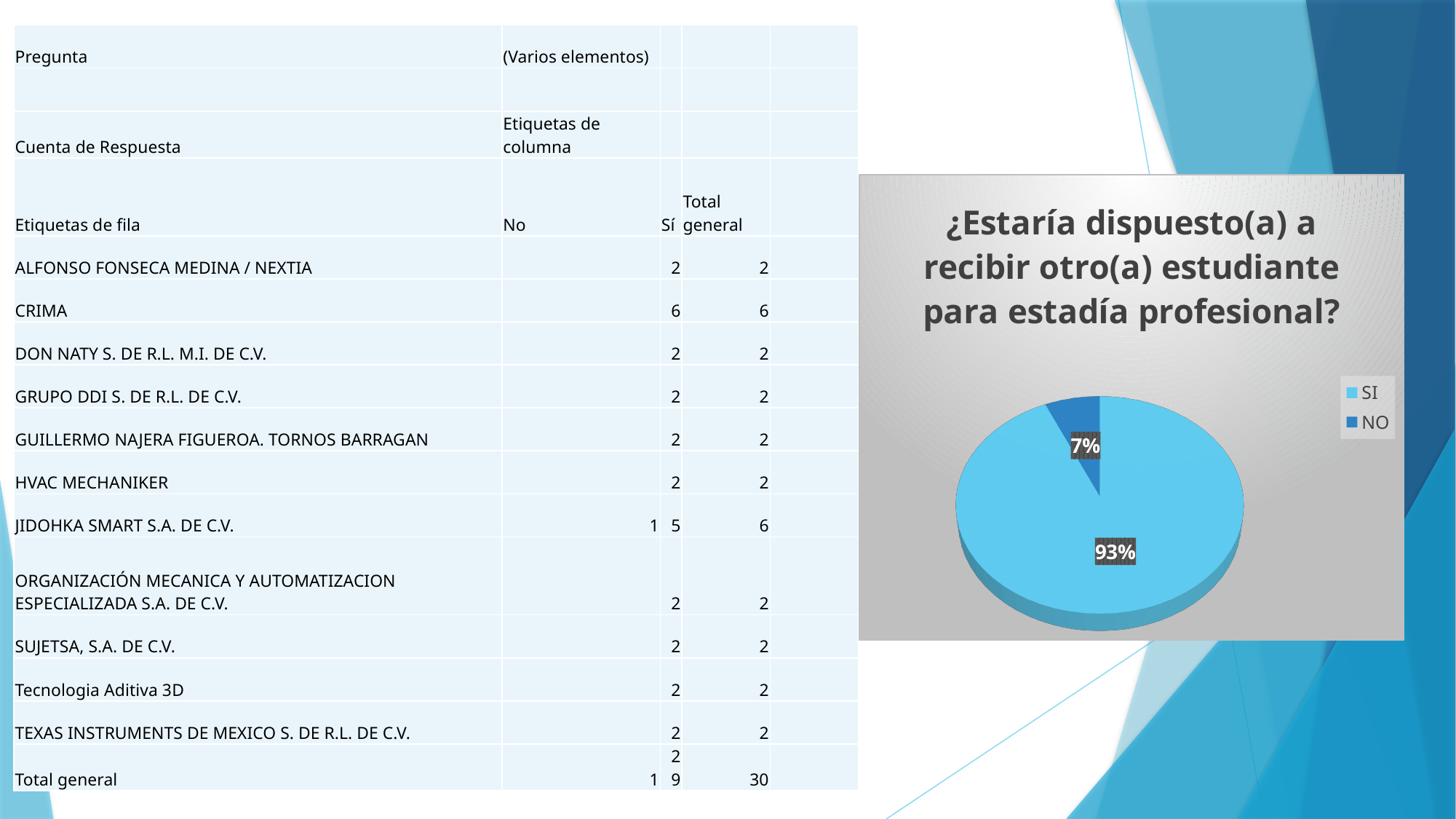
What is the difference in percentage points between the SI and NO slices? 86 What kind of chart is shown on the slide? pie chart Which category has the smallest slice of the pie? NO Which legend entry is shown in the darker blue colour? NO What is the title of the pie chart? ¿Estaría dispuesto(a) a recibir otro(a) estudiante para estadía profesional? What share of the pie does SI represent? 93% What share of the pie does NO represent? 7% Which slice is larger, SI or NO? SI How many entries does the legend list? 2 Which category has the largest slice of the pie? SI How many categories does the pie chart show? 2